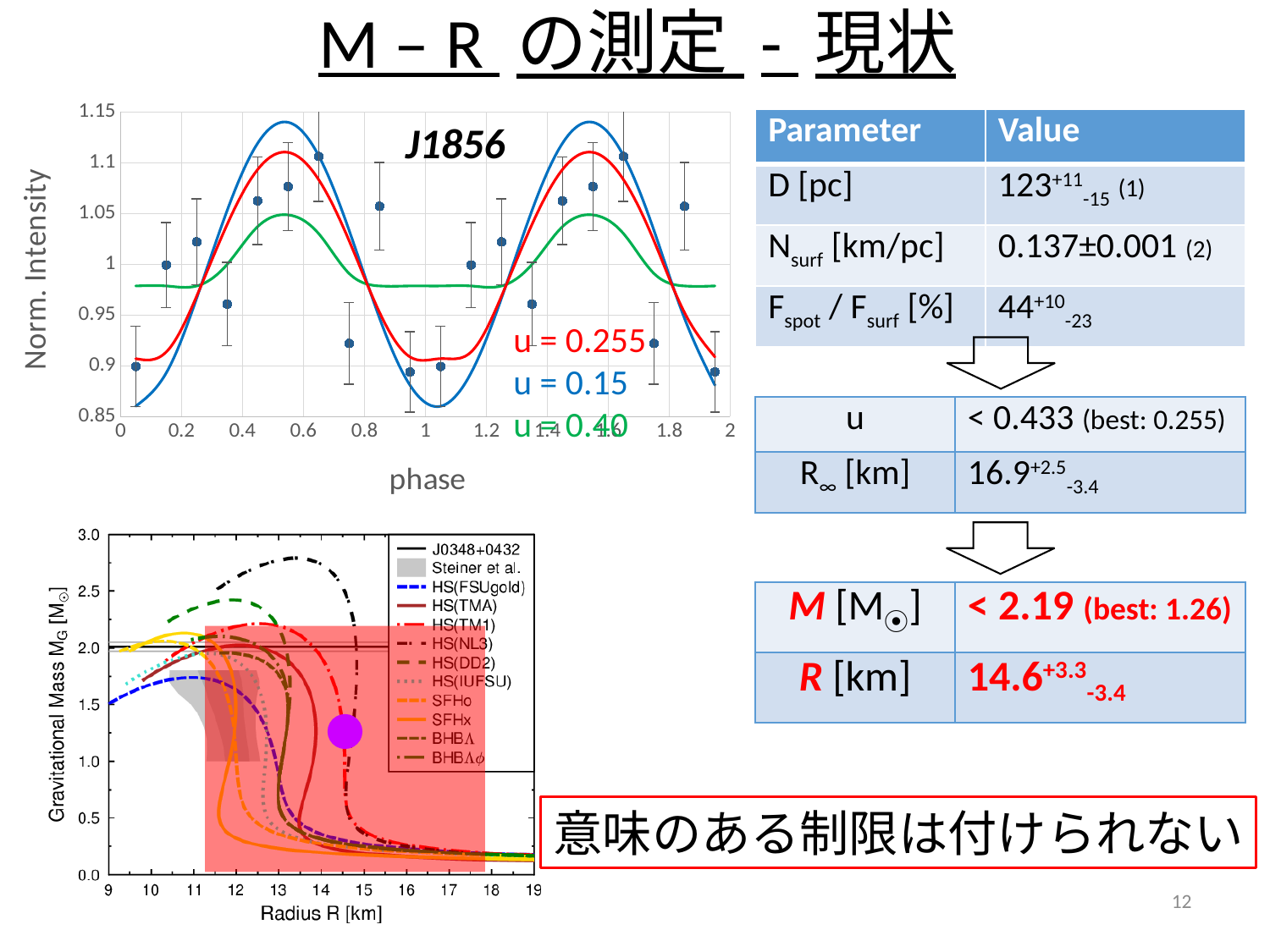
In the bottom-left mass-radius chart, is the maximum mass reached by the HS(NL3) curve greater or less than 2.5? greater In the bottom-left mass-radius chart, which equation of state curve reaches the highest gravitational mass? HS(NL3) In the J1856 chart, is the minimum of the green (u = 0.40) curve greater or less than 0.95? greater What kind of chart is the top-left chart titled J1856? line chart In the bottom-left mass-radius chart, how many entries does the legend list? 12 In the J1856 chart, which curve has the largest amplitude (highest peak)? u = 0.15 (blue) In the J1856 chart, is the peak of the blue (u = 0.15) curve greater or less than 1.1? greater What is the title of the top-left chart? J1856 In the J1856 chart, which curve is the flattest (smallest amplitude)? u = 0.40 (green) In the J1856 chart, what is the label of the x axis? phase In the J1856 chart, what u value does the blue curve correspond to? u = 0.15 In the J1856 chart, how many fitted curves (u values) are drawn? 3